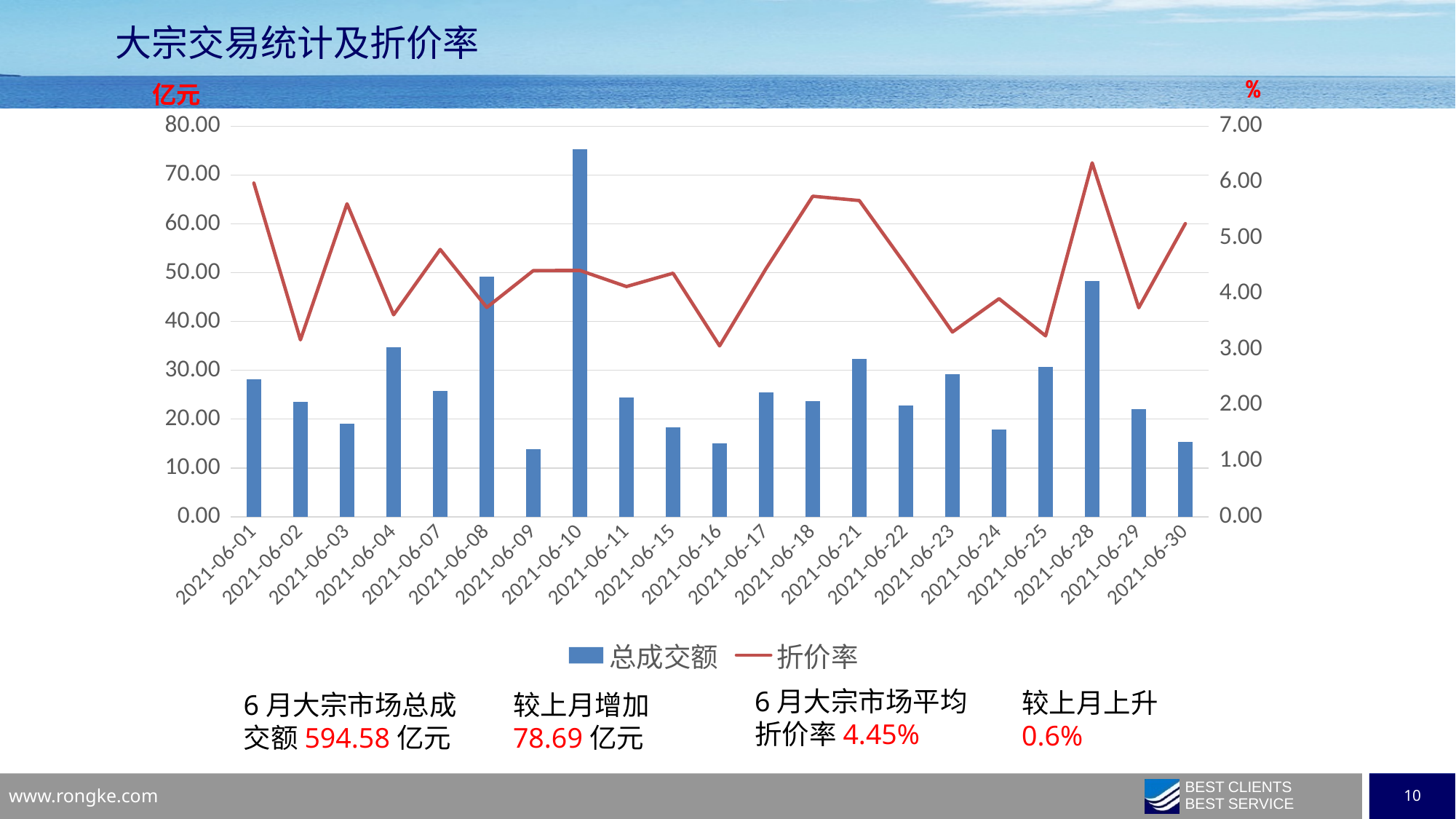
What kind of chart is shown on the slide? A combined bar and line chart Is the 折价率 value for 2021-06-16 greater or less than 4.00? less Is the 总成交额 value for 2021-06-10 greater or less than 70.00? greater How many series does the legend list? 2 What is the title of the chart? 大宗交易统计及折价率 How many dates are shown on the x axis? 21 Is the 折价率 value for 2021-06-18 greater or less than 5.00? greater Which series is drawn as a red line? 折价率 Which has the larger 总成交额 bar, 2021-06-10 or 2021-06-28? 2021-06-10 On which date is the 总成交额 bar the highest? 2021-06-10 On which date does the 折价率 line reach its highest point? 2021-06-28